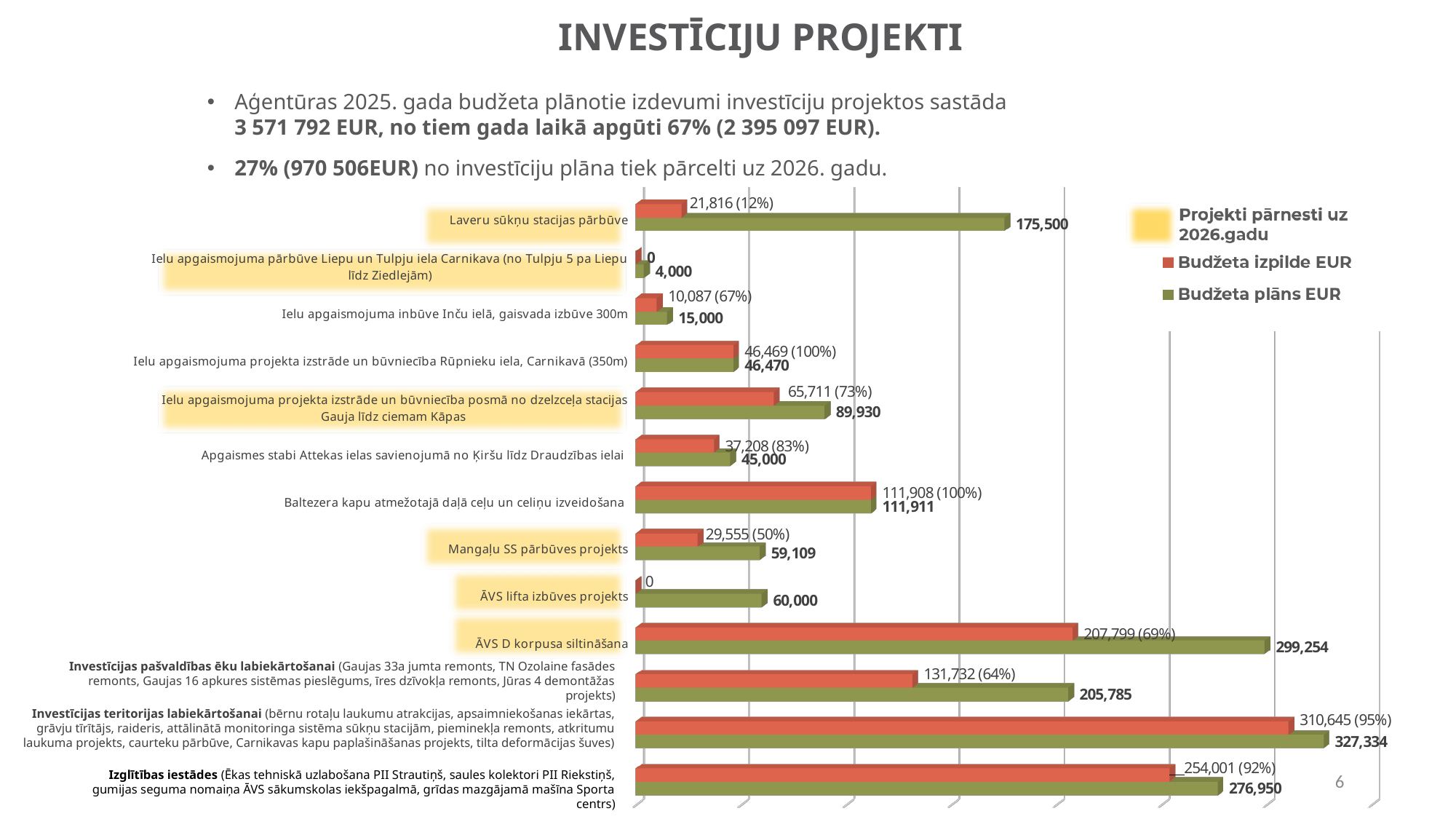
What is the Budžeta izpilde EUR value for ĀVS lifta izbūves projekts? 0 What is the Budžeta plāns EUR value for Laveru sūkņu stacijas pārbūve? 175,500 What percentage of the plan was executed for Mangaļu SS pārbūves projekts? 50% Which project has the highest Budžeta plāns EUR value? Investīcijas teritorijas labiekārtošanai What is the difference between the Budžeta plāns EUR and Budžeta izpilde EUR values for Laveru sūkņu stacijas pārbūve? 153,684 Which project has the lowest Budžeta plāns EUR value? Ielu apgaismojuma pārbūve Liepu un Tulpju iela Carnikava How many projects (categories) are shown in the chart? 13 How many bar series (bar colours) are plotted in the chart? 2 What is the difference between the Budžeta plāns EUR and Budžeta izpilde EUR values for ĀVS D korpusa siltināšana? 91,455 What is the Budžeta izpilde EUR value for ĀVS D korpusa siltināšana? 207,799 Which has the larger Budžeta plāns EUR value: Mangaļu SS pārbūves projekts or ĀVS lifta izbūves projekts? ĀVS lifta izbūves projekts What kind of chart is shown on the slide? Bar chart